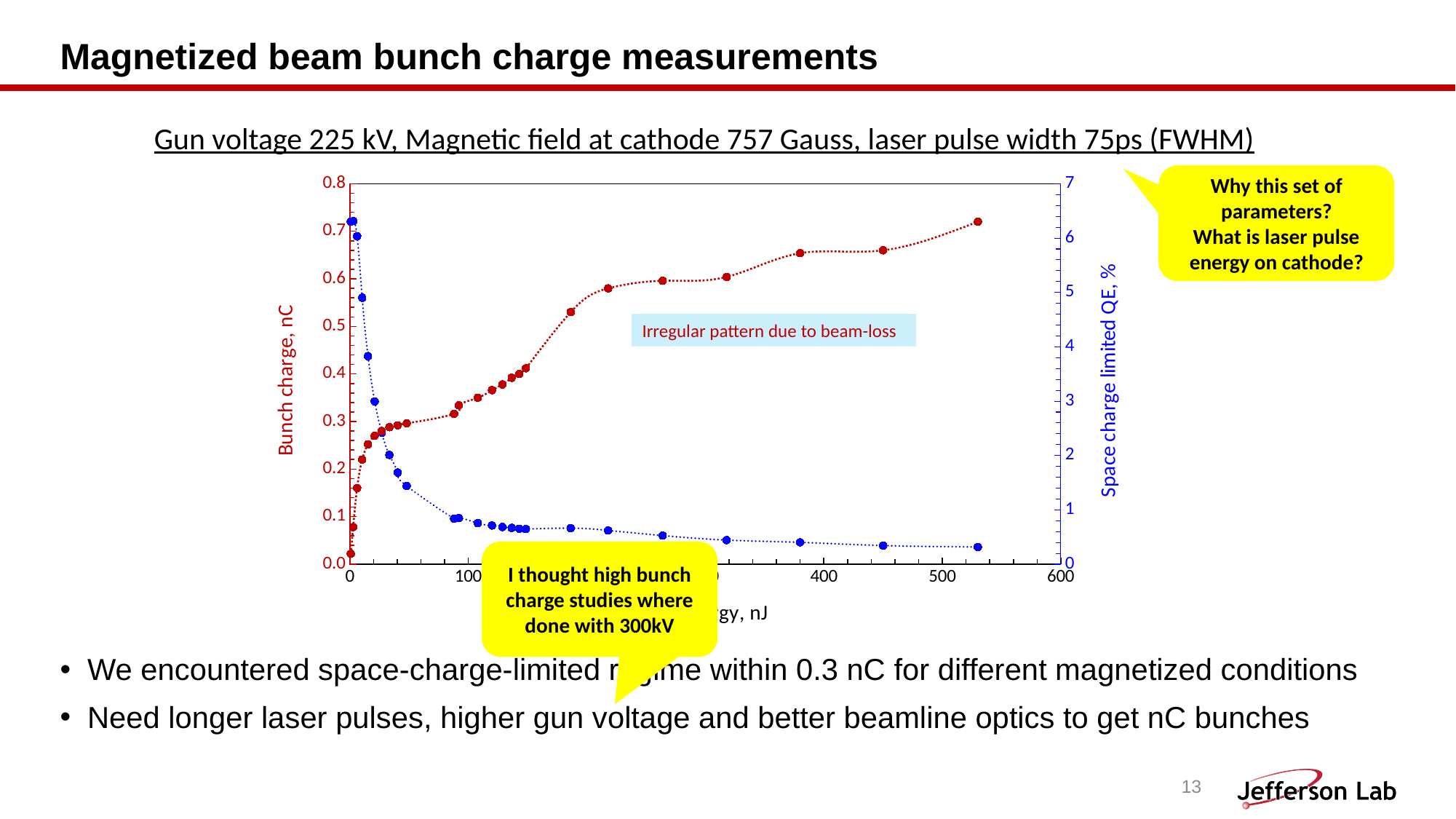
What is the maximum value shown on the x axis? 600 Is the space charge limited QE at the lowest plotted laser pulse energy greater or less than 6%? greater Does the space charge limited QE rise or fall as laser pulse energy increases along the x axis? fall How many data series are plotted on the chart? 2 Is the space charge limited QE at the highest plotted laser pulse energy greater or less than 1%? less Is the bunch charge at the highest plotted laser pulse energy greater or less than 0.6 nC? greater What kind of chart is shown on the slide? line chart Does the bunch charge rise or fall as laser pulse energy increases along the x axis? rise What is the label of the right vertical axis? Space charge limited QE, % Which series reaches its maximum at the lowest laser pulse energy? Space charge limited QE What is the label of the left vertical axis? Bunch charge, nC